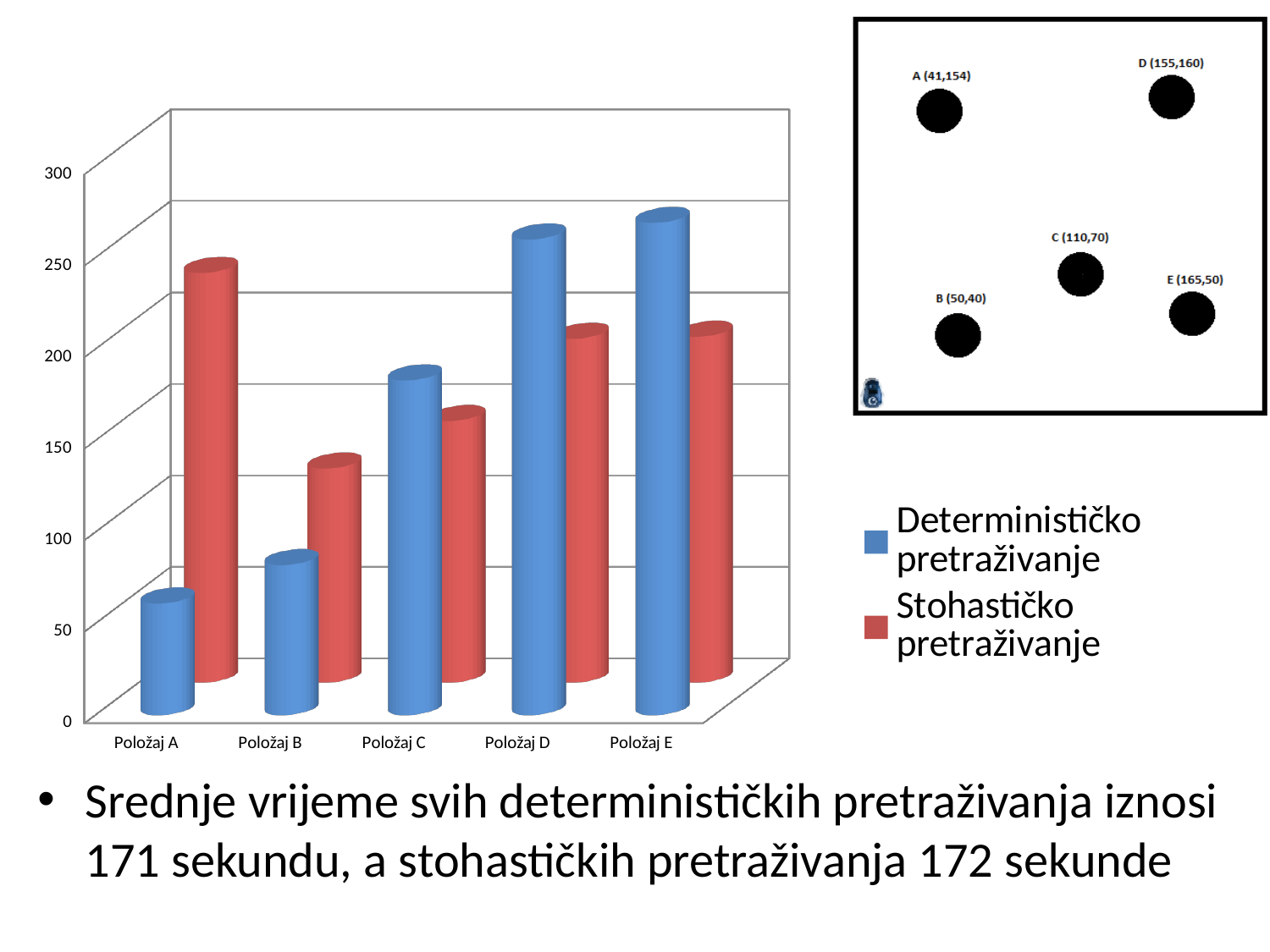
At Položaj B, which series has the larger value: Determinističko pretraživanje or Stohastičko pretraživanje? Stohastičko pretraživanje Is the value for Determinističko pretraživanje at Položaj D greater or less than 200? greater Is the value for Determinističko pretraživanje at Položaj A greater or less than 100? less Which category has the highest value for Stohastičko pretraživanje? Položaj A Is the value for Stohastičko pretraživanje at Položaj A greater or less than 200? greater How many categories (položaji) are shown on the x axis of the chart? 5 How many series does the chart legend list? 2 What kind of chart is shown on the slide? bar chart What colour represents Stohastičko pretraživanje in the chart legend? red Which category has the lowest value for Determinističko pretraživanje? Položaj A At Položaj D, which series has the larger value: Determinističko pretraživanje or Stohastičko pretraživanje? Determinističko pretraživanje Which category has the lowest value for Stohastičko pretraživanje? Položaj B